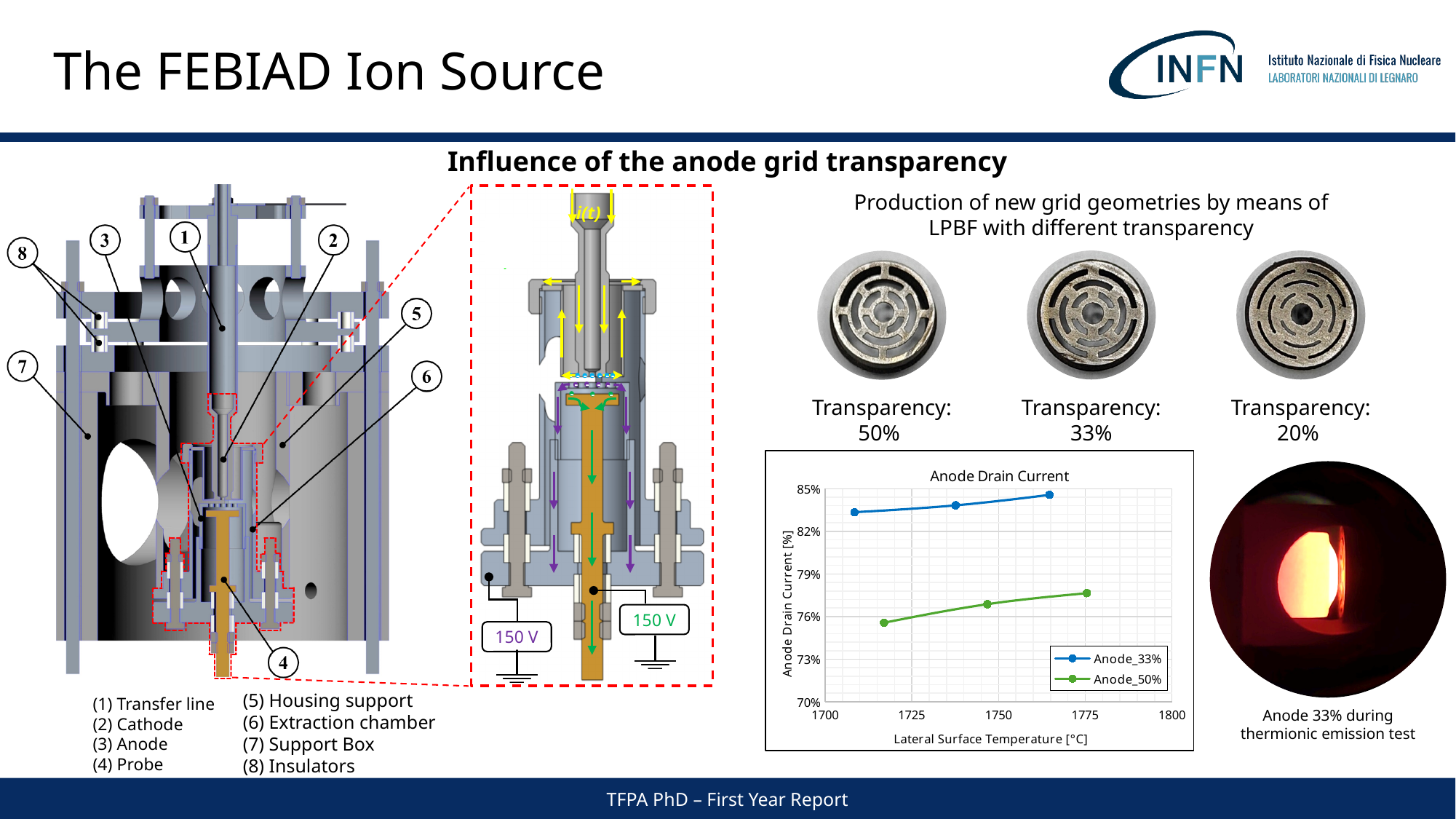
In the Anode Drain Current chart, are the Anode_50% values greater or less than 79%? less How many data points are plotted for the Anode_33% series in the Anode Drain Current chart? 3 In the Anode Drain Current chart, is the lowest Anode_50% point greater or less than 76%? less In the Anode Drain Current chart, are the Anode_33% values greater or less than 82%? greater In the Anode Drain Current chart, does the Anode_33% series rise or fall as lateral surface temperature increases? Rise Which series are listed in the legend of the Anode Drain Current chart? Anode_33% and Anode_50% In the Anode Drain Current chart, which series has the higher anode drain current values, Anode_33% or Anode_50%? Anode_33% In the Anode Drain Current chart, does the Anode_50% series rise or fall as lateral surface temperature increases? Rise What is the label of the x axis of the Anode Drain Current chart? Lateral Surface Temperature [°C] How many data points are plotted for the Anode_50% series in the Anode Drain Current chart? 3 What kind of chart is the Anode Drain Current chart? Line chart How many series does the legend of the Anode Drain Current chart list? 2